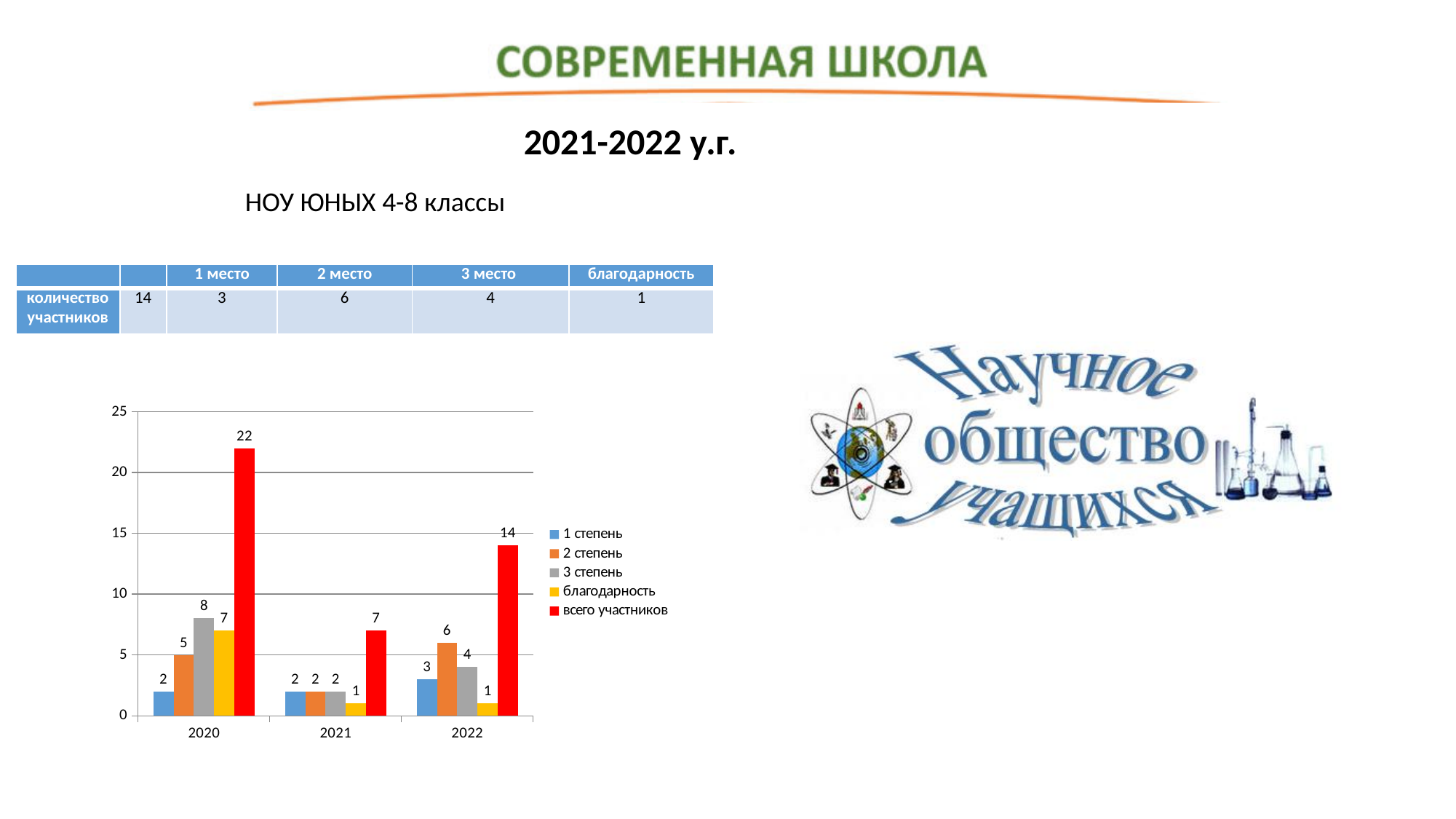
In which year is 'всего участников' the highest? 2020 What is the value of 'всего участников' for 2020? 22 Which colour represents 'всего участников' in the chart legend? red How many series does the chart legend list? 5 Which is larger: '2 степень' in 2022 or '2 степень' in 2020? 2 степень in 2022 What is the difference between 'всего участников' in 2020 and in 2022? 8 Is the value of 'всего участников' for 2020 greater or less than 20? greater What is the value of 'благодарность' for 2021? 1 What type of chart is shown on the slide? bar chart What is the value of '3 степень' for 2022? 4 How many year categories are shown on the x axis of the chart? 3 In which year is 'всего участников' the lowest? 2021